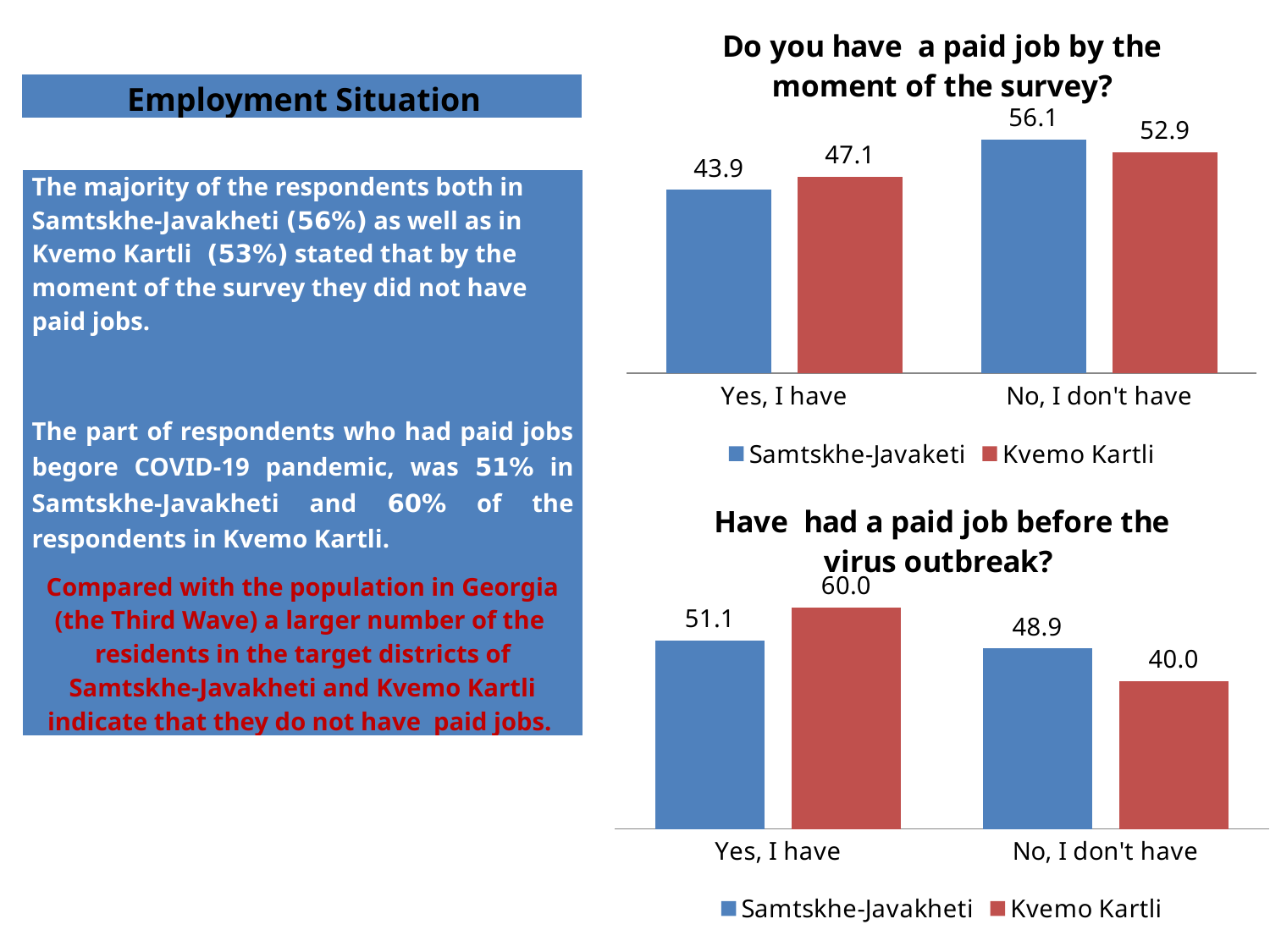
What kind of chart is the chart titled "Have had a paid job before the virus outbreak?"? Bar chart In the chart titled "Have had a paid job before the virus outbreak?", which series has the lowest value for "No, I don't have"? Kvemo Kartli In the chart titled "Do you have a paid job by the moment of the survey?", what is the value for Kvemo Kartli for "No, I don't have"? 52.9 In the chart titled "Do you have a paid job by the moment of the survey?", what is the value for Samtskhe-Javaketi for "Yes, I have"? 43.9 In the chart titled "Have had a paid job before the virus outbreak?", which is larger for "Yes, I have": Samtskhe-Javakheti or Kvemo Kartli? Kvemo Kartli In the chart titled "Do you have a paid job by the moment of the survey?", how many categories are shown on the x axis? 2 In the chart titled "Have had a paid job before the virus outbreak?", what is the difference between the Kvemo Kartli and Samtskhe-Javakheti values for "Yes, I have"? 8.9 In the chart titled "Have had a paid job before the virus outbreak?", what is the value for Kvemo Kartli for "Yes, I have"? 60.0 In the chart titled "Do you have a paid job by the moment of the survey?", how many series does the legend list? 2 In the chart titled "Do you have a paid job by the moment of the survey?", what is the difference between the Samtskhe-Javaketi and Kvemo Kartli values for "No, I don't have"? 3.2 In the chart titled "Do you have a paid job by the moment of the survey?", which category has the highest value for Samtskhe-Javaketi? No, I don't have In the chart titled "Have had a paid job before the virus outbreak?", what is the value for Samtskhe-Javakheti for "No, I don't have"? 48.9